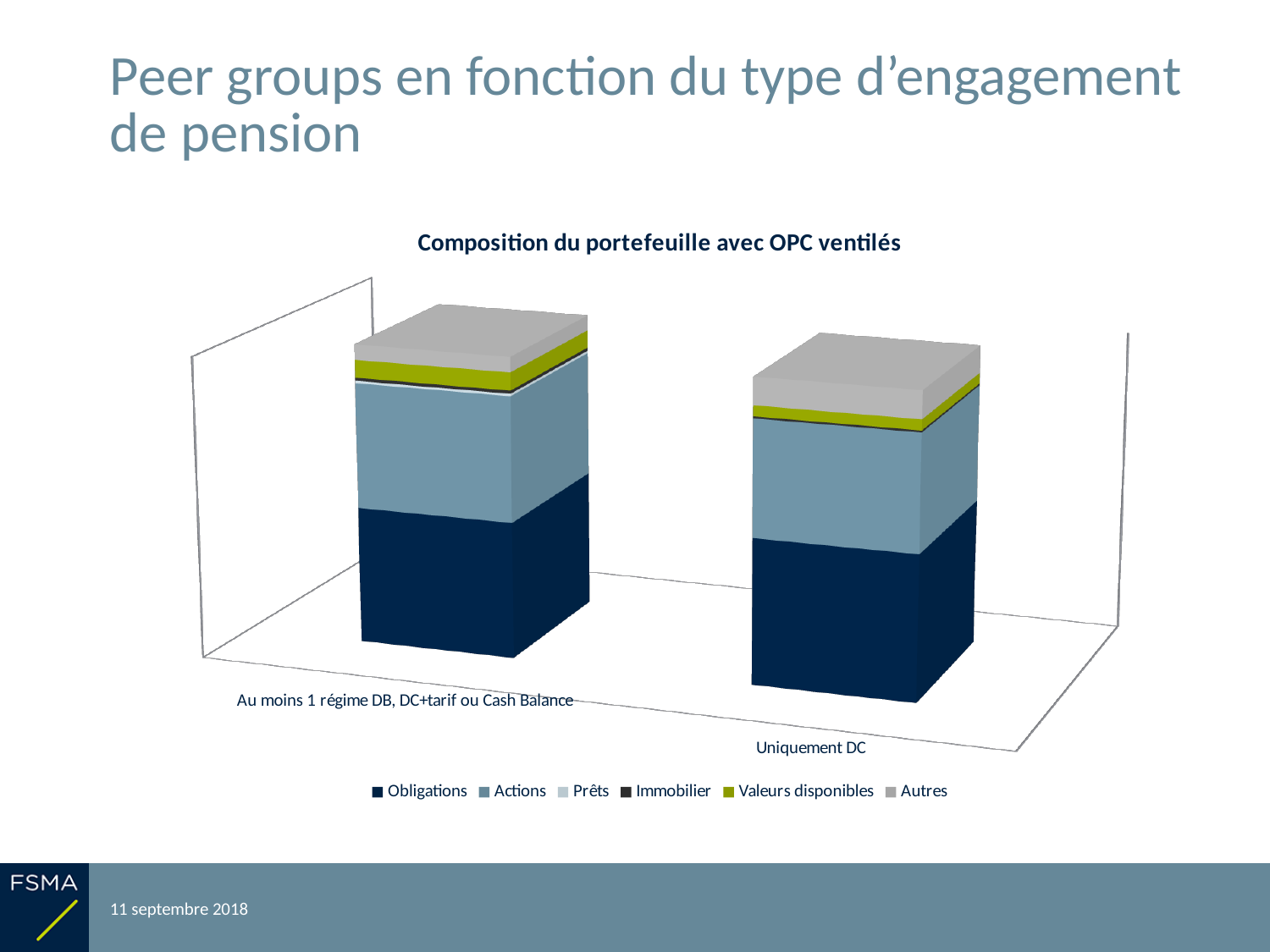
How many series does the chart legend list? 6 What kind of chart is shown on the slide? Stacked bar chart Which series is listed first in the chart legend? Obligations In the bar for 'Uniquement DC', which segment is larger: Obligations or Actions? Obligations In the bar for 'Uniquement DC', which segment is larger: Actions or Autres? Actions What is the title of the chart? Composition du portefeuille avec OPC ventilés Which series forms the largest segment of the bar for 'Au moins 1 régime DB, DC+tarif ou Cash Balance'? Obligations Which series forms the largest segment of the bar for 'Uniquement DC'? Obligations How many categories are shown on the x axis of the chart? 2